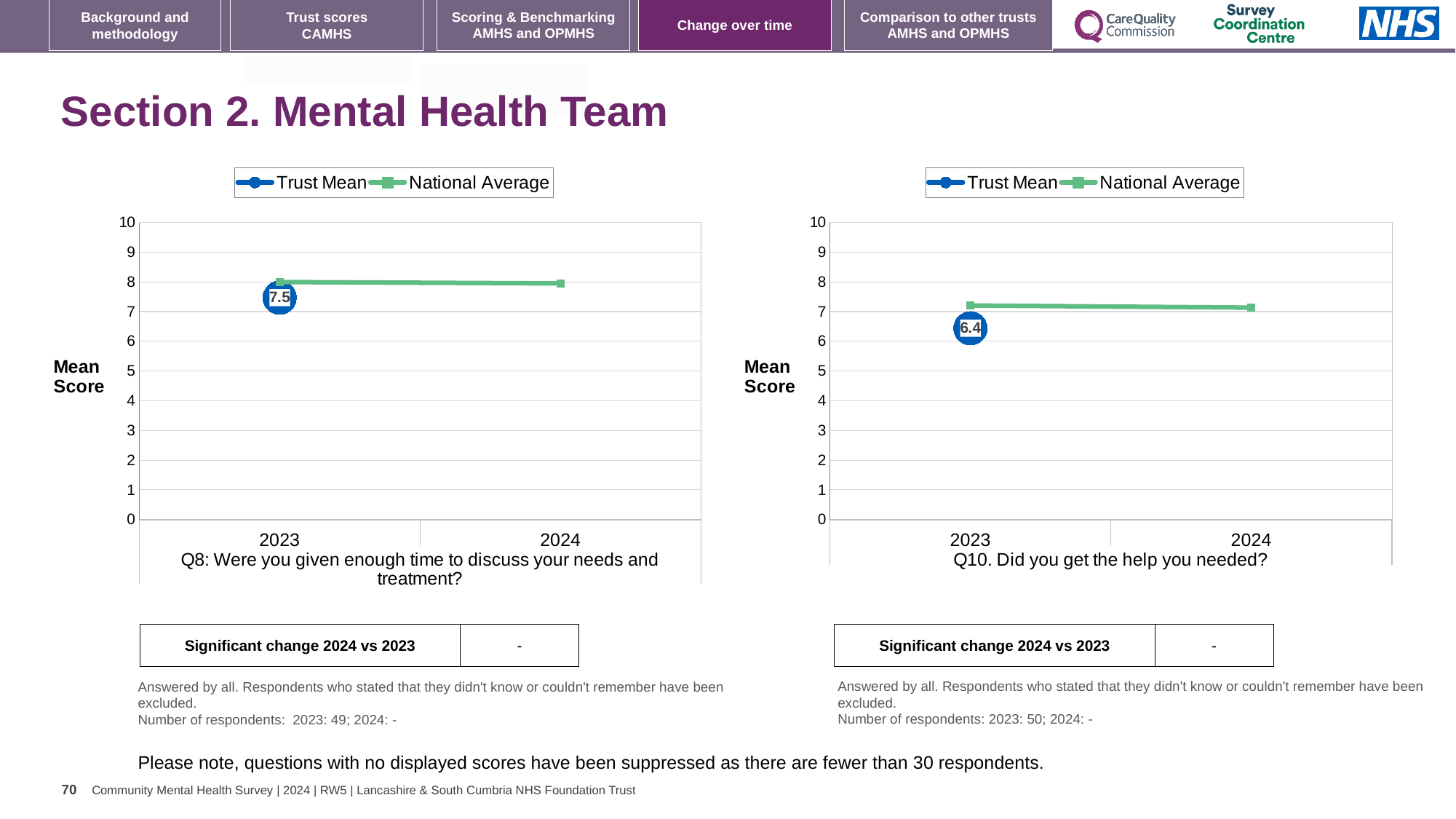
In the right chart (Q10), which is higher for 2023: the Trust Mean or the National Average? National Average In the left chart (Q8), is the National Average value for 2024 greater or less than 9? less In the left chart (Q8), is the National Average value for 2023 greater or less than 7? greater What is the label on the y axis of the right chart (Q10)? Mean Score What kind of chart is the left chart (Q8)? Line chart In the left chart (Q8), which is higher for 2023: the Trust Mean or the National Average? National Average In the right chart (Q10), is the National Average value for 2024 greater or less than 8? less In the left chart (Q8: Were you given enough time to discuss your needs and treatment?), what is the Trust Mean value for 2023? 7.5 How many years are shown on the x axis of the left chart (Q8)? 2 How many series does the legend of the right chart (Q10) list? 2 In the right chart (Q10. Did you get the help you needed?), what is the Trust Mean value for 2023? 6.4